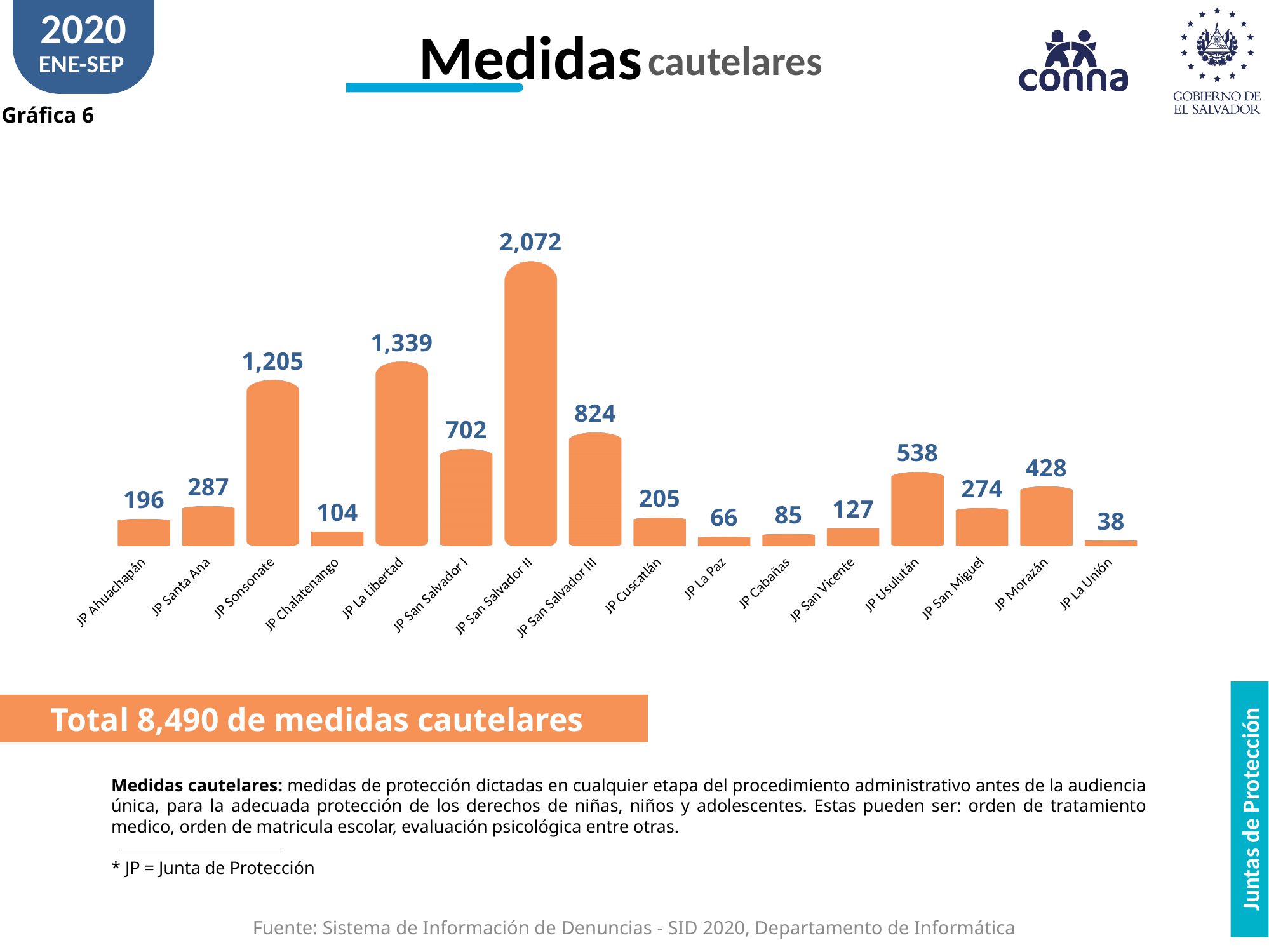
What is the value for JP San Salvador II? 2,072 What is the value for JP La Unión? 38 What is the difference between the values for JP Cabañas and JP La Paz? 19 What is the value for JP Sonsonate? 1,205 How many categories are shown on the x axis? 16 Which category has the highest value? JP San Salvador II What is the difference between the values for JP La Libertad and JP San Salvador I? 637 What total of medidas cautelares is stated on the slide? 8,490 What kind of chart is shown on the slide? bar chart What is the value for JP San Salvador III? 824 Which is larger, the value for JP Usulután or the value for JP Morazán? JP Usulután Which category has the lowest value? JP La Unión